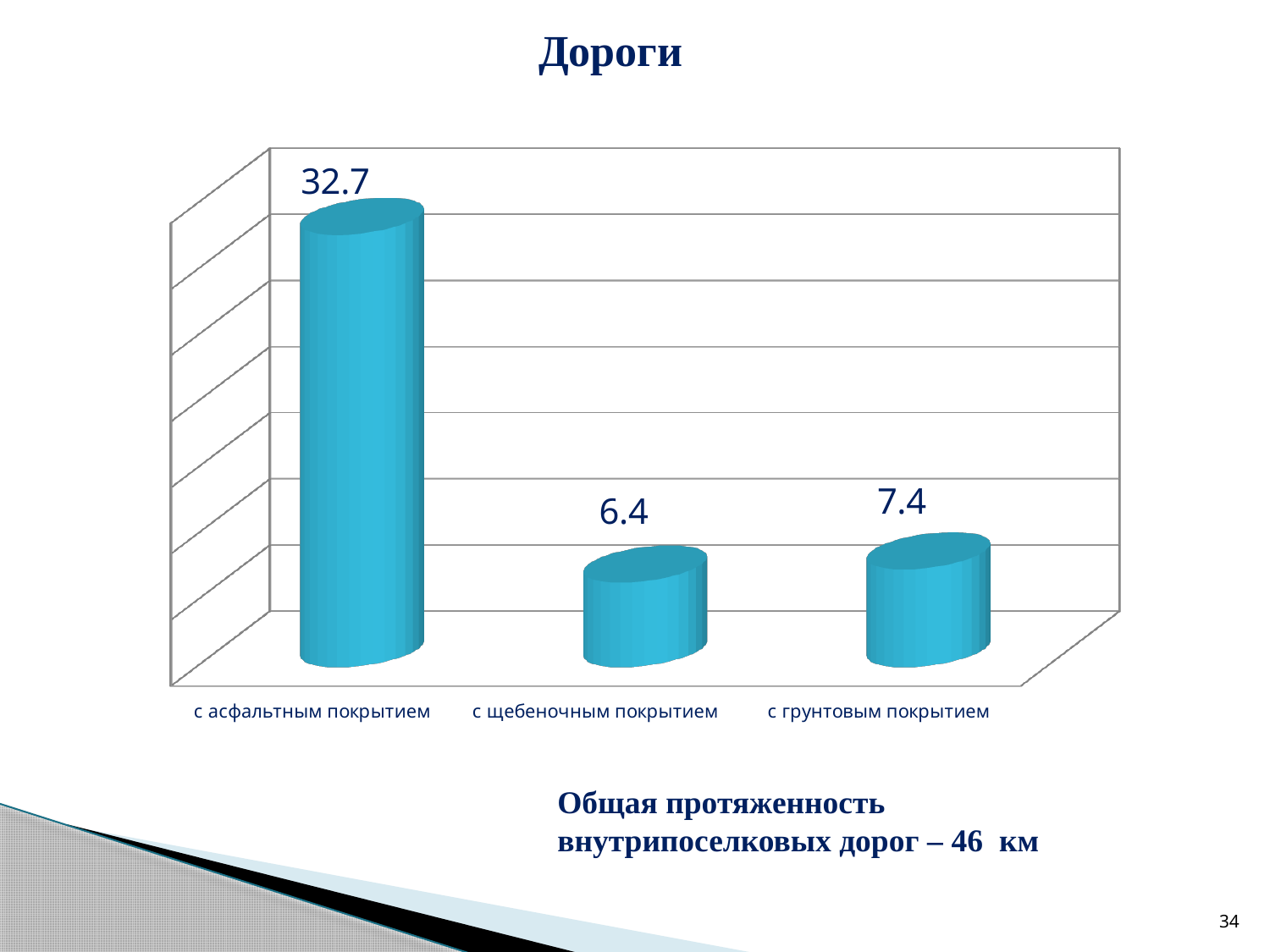
What is the value for 'с щебеночным покрытием'? 6.4 What colour are the bars in the chart? blue How many categories are shown in the chart? 3 What is the difference between the values for 'с грунтовым покрытием' and 'с щебеночным покрытием'? 1.0 Which category has the highest value? с асфальтным покрытием What is the value for 'с грунтовым покрытием'? 7.4 What kind of chart is shown on the slide? bar chart Which category has the lowest value? с щебеночным покрытием What is the difference between the values for 'с асфальтным покрытием' and 'с грунтовым покрытием'? 25.3 What is the title of the slide? Дороги What is the value for 'с асфальтным покрытием'? 32.7 Which is larger, the value for 'с грунтовым покрытием' or 'с щебеночным покрытием'? с грунтовым покрытием